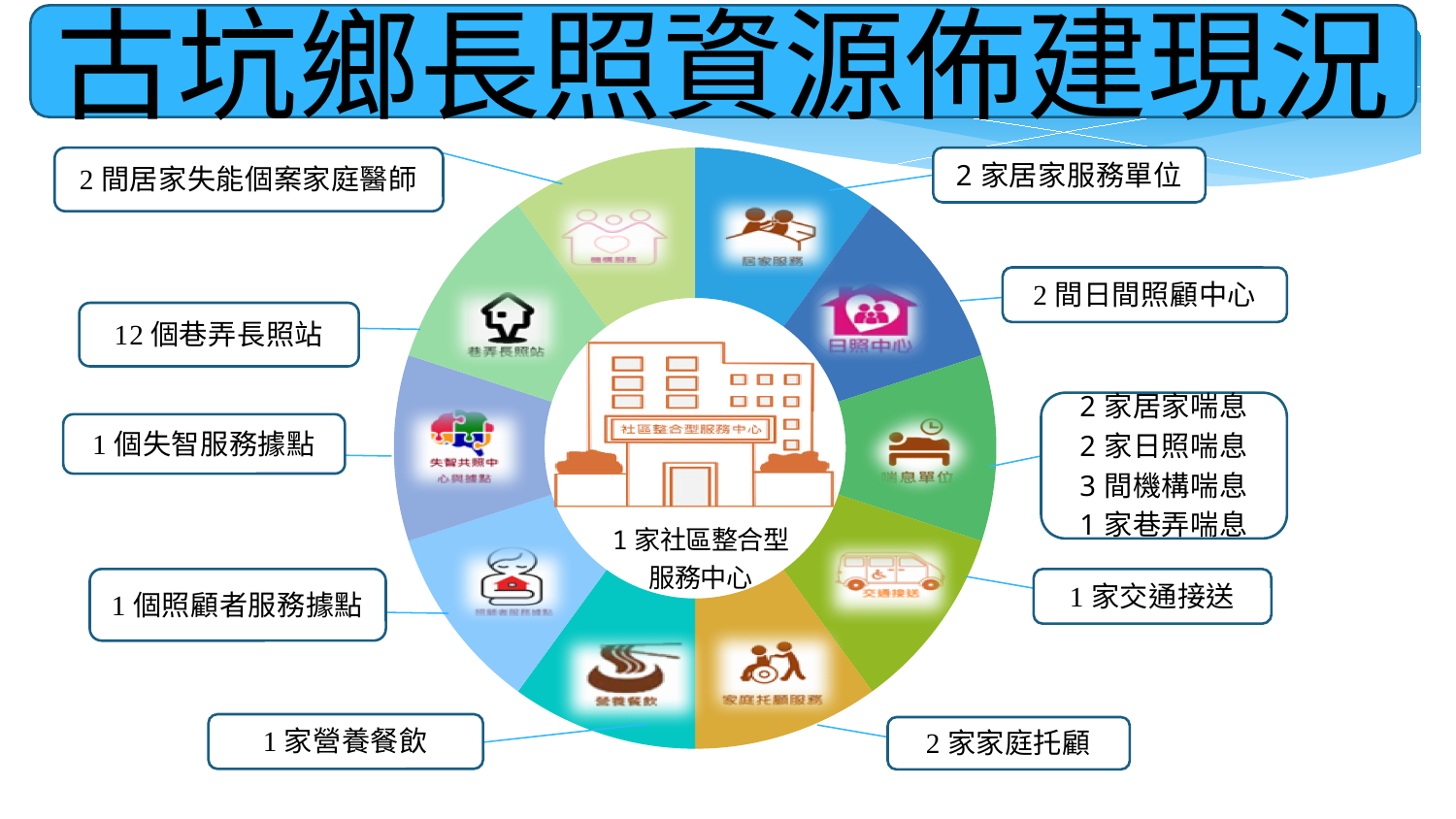
Which resource type has the largest count on the slide? 巷弄長照站 What is written in the centre of the ring diagram? 1 家社區整合型服務中心 How many 日間照顧中心 are listed on the slide? 2 間 How many 巷弄長照站 are listed on the slide? 12 個 What is the difference between the number of 巷弄長照站 and the number of 居家失能個案家庭醫師? 10 Which is larger, the number of 巷弄長照站 or the number of 日間照顧中心? 巷弄長照站 What is the title of the slide? 古坑鄉長照資源佈建現況 What kind of diagram is shown on the slide? A ring (donut) diagram How many 居家服務單位 are listed on the slide? 2 家 How many 家庭托顧 are listed on the slide? 2 家 How many segments does the ring diagram have? 10 How many 機構喘息 are listed on the slide? 3 間